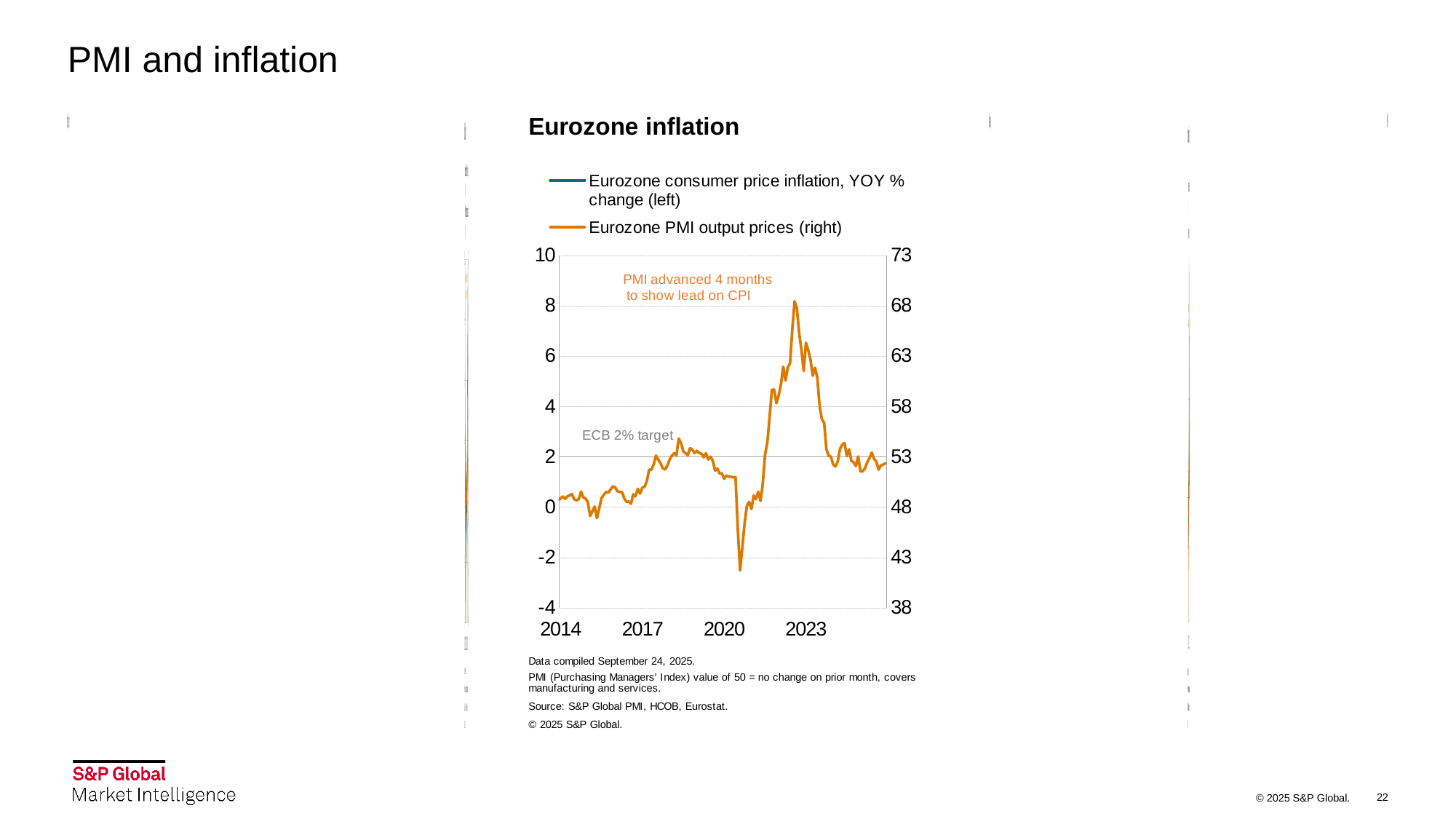
Is the peak of the Eurozone PMI output prices line, reached around 2022, greater or less than 63 on the right axis? greater Does the Eurozone PMI output prices line rise or fall from its 2022 peak to 2023? fall What is the highest value shown on the right-hand axis of the "Eurozone inflation" chart? 73 What kind of chart is shown under the title "Eurozone inflation"? line chart Which series in the "Eurozone inflation" chart is plotted against the right axis? Eurozone PMI output prices Is the Eurozone PMI output prices value at the end of the series (2025) greater or less than 58 on the right axis? less Does the Eurozone PMI output prices line rise or fall between its 2020 trough and its 2022 peak? rise By how many months has the PMI series been advanced in the "Eurozone inflation" chart, according to the annotation? 4 months How many series does the legend of the "Eurozone inflation" chart list? 2 How many year labels are shown on the x axis of the "Eurozone inflation" chart? 4 Is the lowest point of the Eurozone PMI output prices line, around 2020, greater or less than 48 on the right axis? less